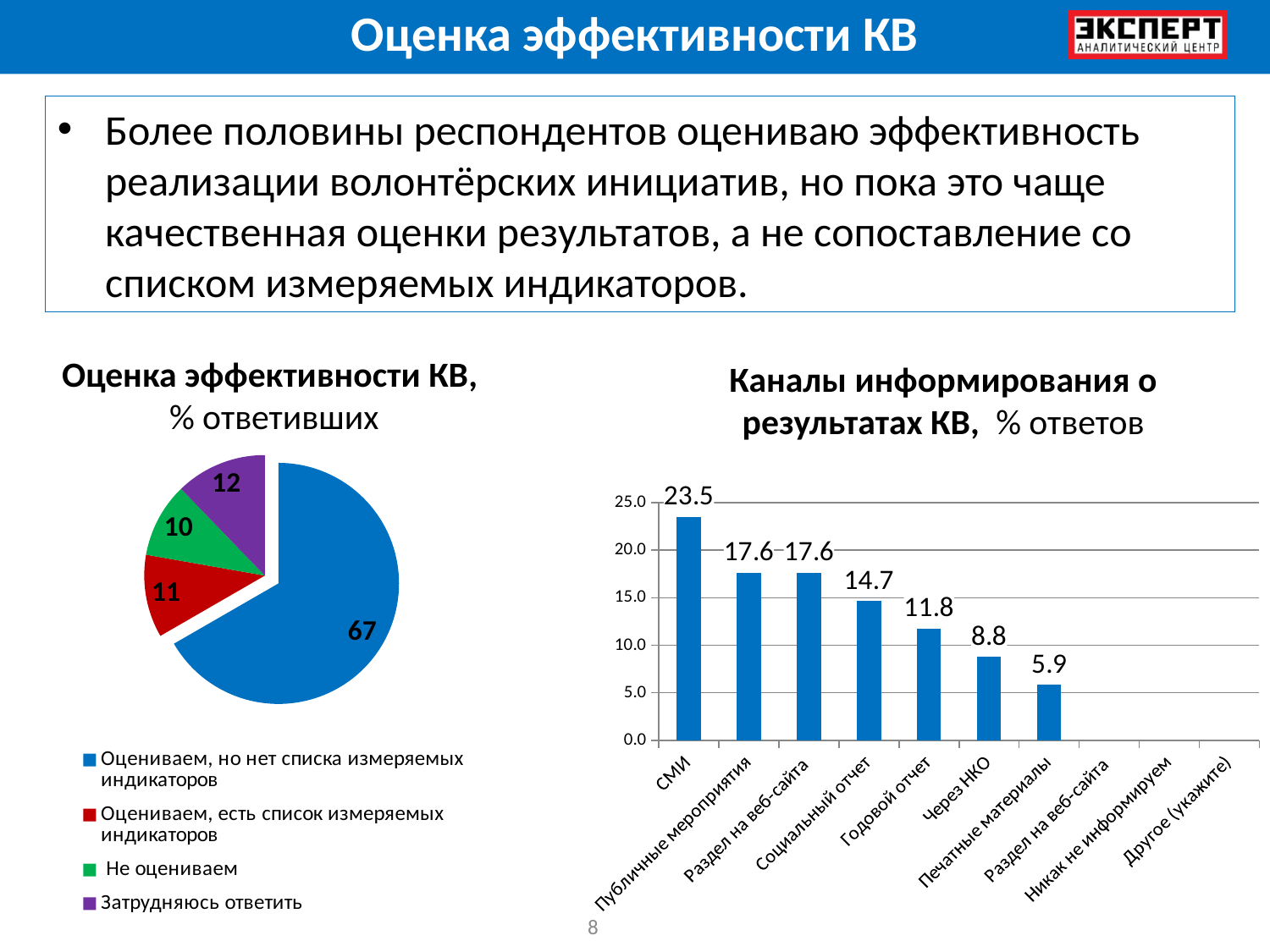
In the pie chart 'Оценка эффективности КВ', how many categories does the legend list? 4 In the pie chart 'Оценка эффективности КВ', which category has the largest slice? Оцениваем, но нет списка измеряемых индикаторов In the bar chart 'Каналы информирования о результатах КВ', what is the difference between the values for 'СМИ' and 'Печатные материалы'? 17.6 In the pie chart 'Оценка эффективности КВ', what value is shown for 'Оцениваем, но нет списка измеряемых индикаторов'? 67 What type of chart is 'Каналы информирования о результатах КВ'? Bar chart In the bar chart 'Каналы информирования о результатах КВ', which category has the highest value? СМИ In the pie chart 'Оценка эффективности КВ', which category has the smallest slice? Не оцениваем In the bar chart 'Каналы информирования о результатах КВ', which is larger: the value for 'Социальный отчет' or for 'Через НКО'? Социальный отчет In the pie chart 'Оценка эффективности КВ', what colour is the slice for 'Затрудняюсь ответить'? Purple In the pie chart 'Оценка эффективности КВ', what value is shown for 'Не оцениваем'? 10 In the bar chart 'Каналы информирования о результатах КВ', what is the value for 'Годовой отчет'? 11.8 In the bar chart 'Каналы информирования о результатах КВ', what is the value for 'СМИ'? 23.5